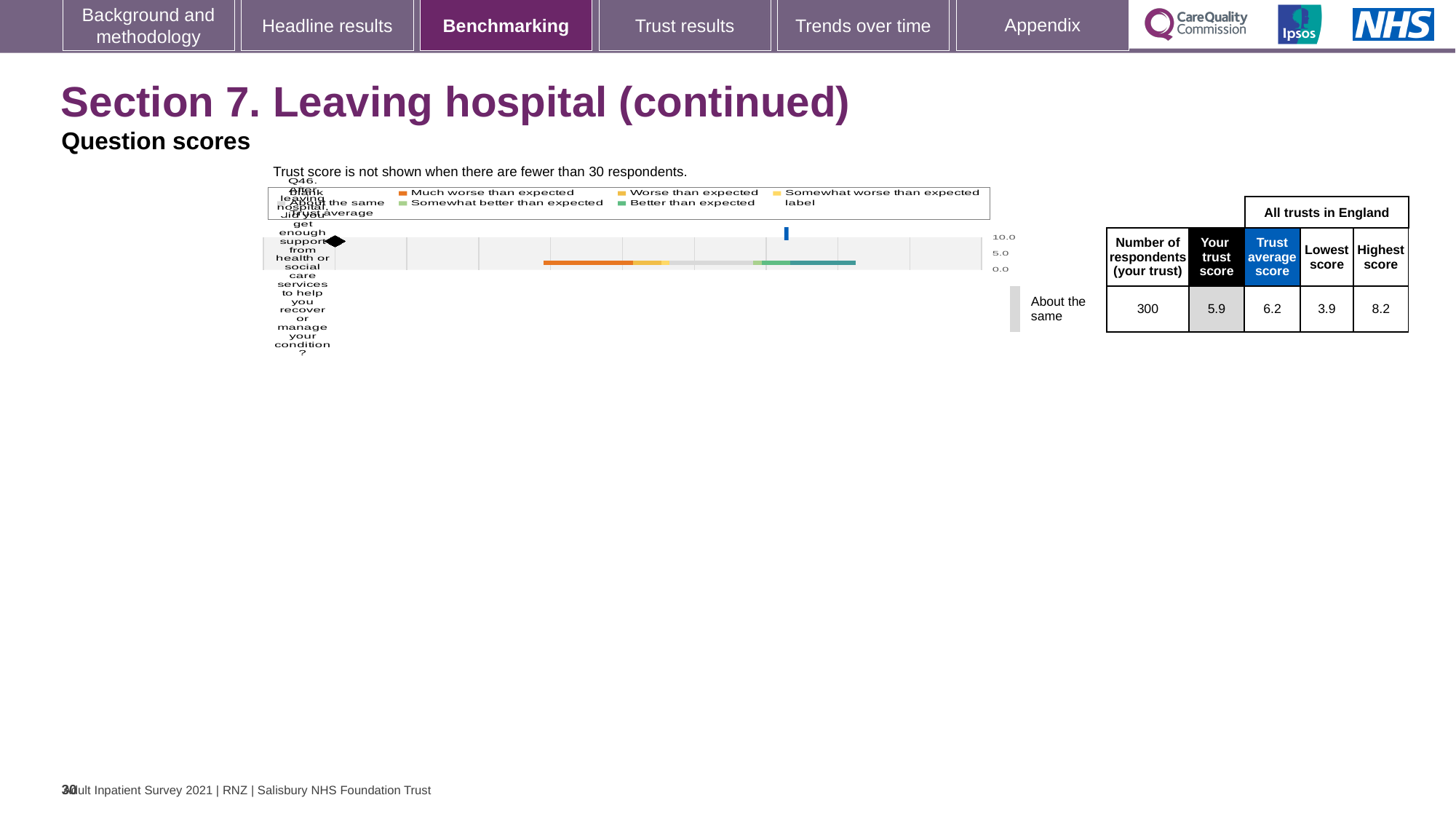
What is the difference between the highest score and the lowest score for Q46 across all trusts in England? 4.3 What kind of chart is used to show the Q46 benchmarking result? Bar chart What is the lowest score among all trusts in England for Q46? 3.9 What is the maximum value shown on the chart's score axis? 10.0 What benchmarking category is the trust's Q46 score placed in? About the same What is the trust average score for Q46 across all trusts in England? 6.2 What is the trust score for Q46 shown in the table next to the chart? 5.9 How many respondents from the trust answered Q46? 300 Which is larger for Q46: the trust's own score or the trust average score? Trust average score What is the highest score among all trusts in England for Q46? 8.2 What is the difference between the trust average score and the trust's own score for Q46? 0.3 Is the trust score for Q46 greater or less than 5.0? greater